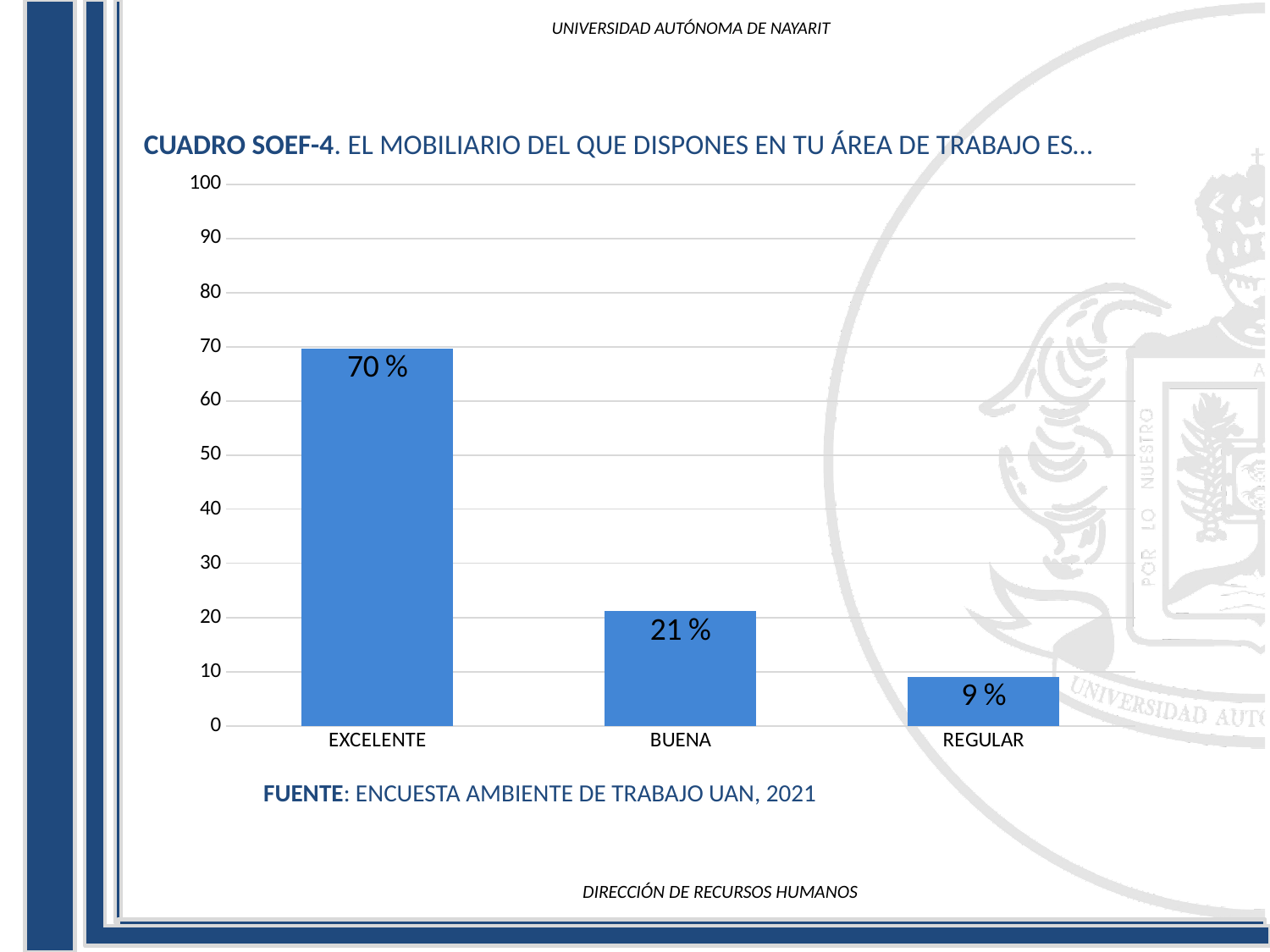
What kind of chart is shown on the slide? bar chart Is the value for BUENA greater or less than 30? less How many categories are shown on the x axis? 3 What is the value for EXCELENTE? 70 % What is the difference between the values for EXCELENTE and BUENA? 49 % What is the value for REGULAR? 9 % What source is cited below the chart? ENCUESTA AMBIENTE DE TRABAJO UAN, 2021 Which category has the highest value? EXCELENTE Which is larger, the value for BUENA or the value for REGULAR? BUENA What is the value for BUENA? 21 % What is the difference between the values for BUENA and REGULAR? 12 % Which category has the lowest value? REGULAR